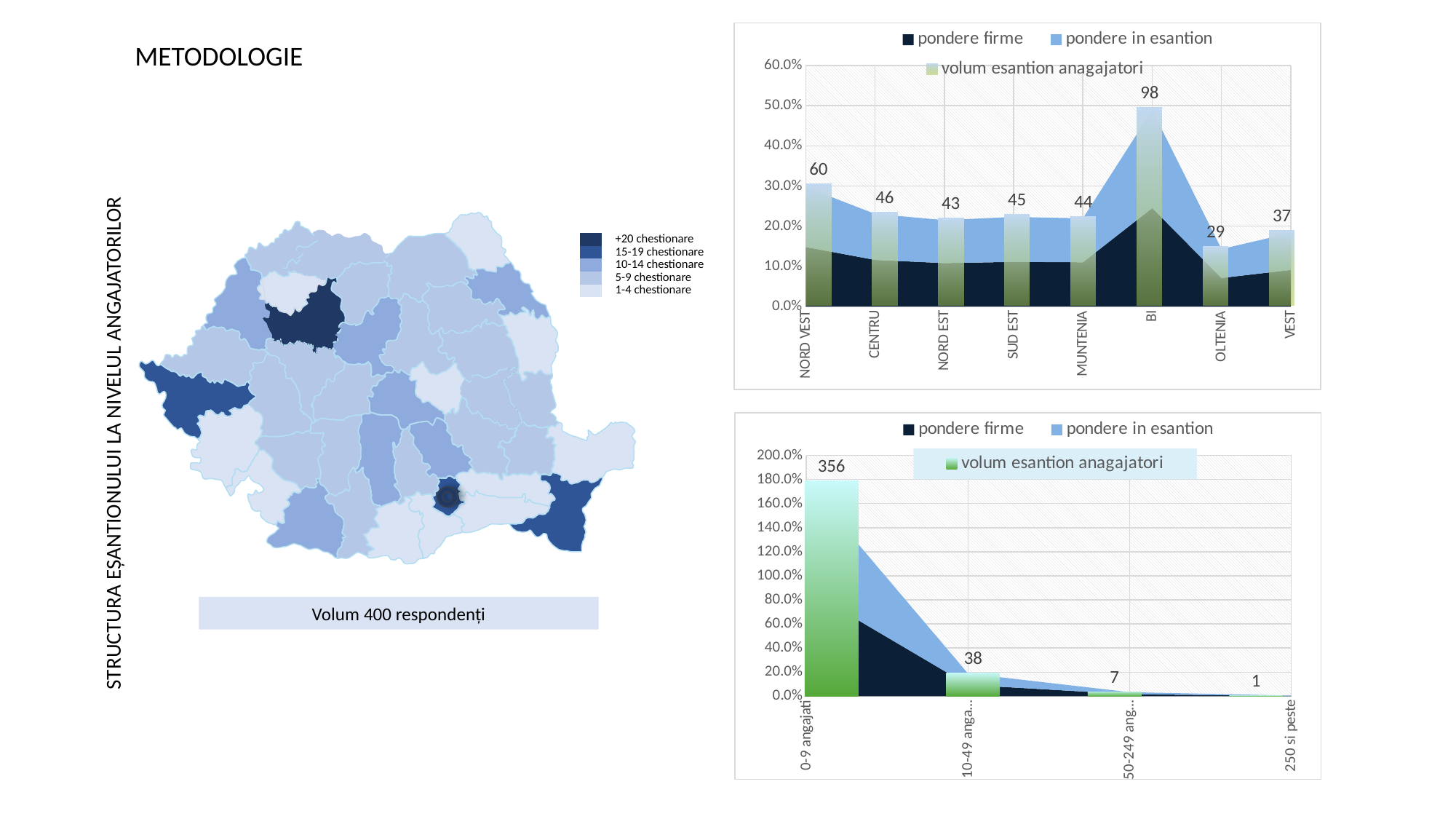
In the top chart, which region has the lowest volum esantion anagajatori value? OLTENIA How many regions are shown on the x axis of the top chart? 8 In the top chart, what is the volum esantion anagajatori value for NORD VEST? 60 In the top chart, what is the volum esantion anagajatori value for BI? 98 In the bottom chart, what is the difference between the volum esantion anagajatori values for 0-9 angajati and 10-49 angajati? 318 How many series does the legend of the top chart list? 3 In the top chart, what is the difference between the volum esantion anagajatori values for NORD VEST and CENTRU? 14 In the top chart, which region has the highest volum esantion anagajatori value? BI In the bottom chart, do the volum esantion anagajatori values rise or fall from left to right along the x axis? fall In the top chart, which has a larger volum esantion anagajatori value, SUD EST or VEST? SUD EST In the bottom chart, what is the volum esantion anagajatori value for 0-9 angajati? 356